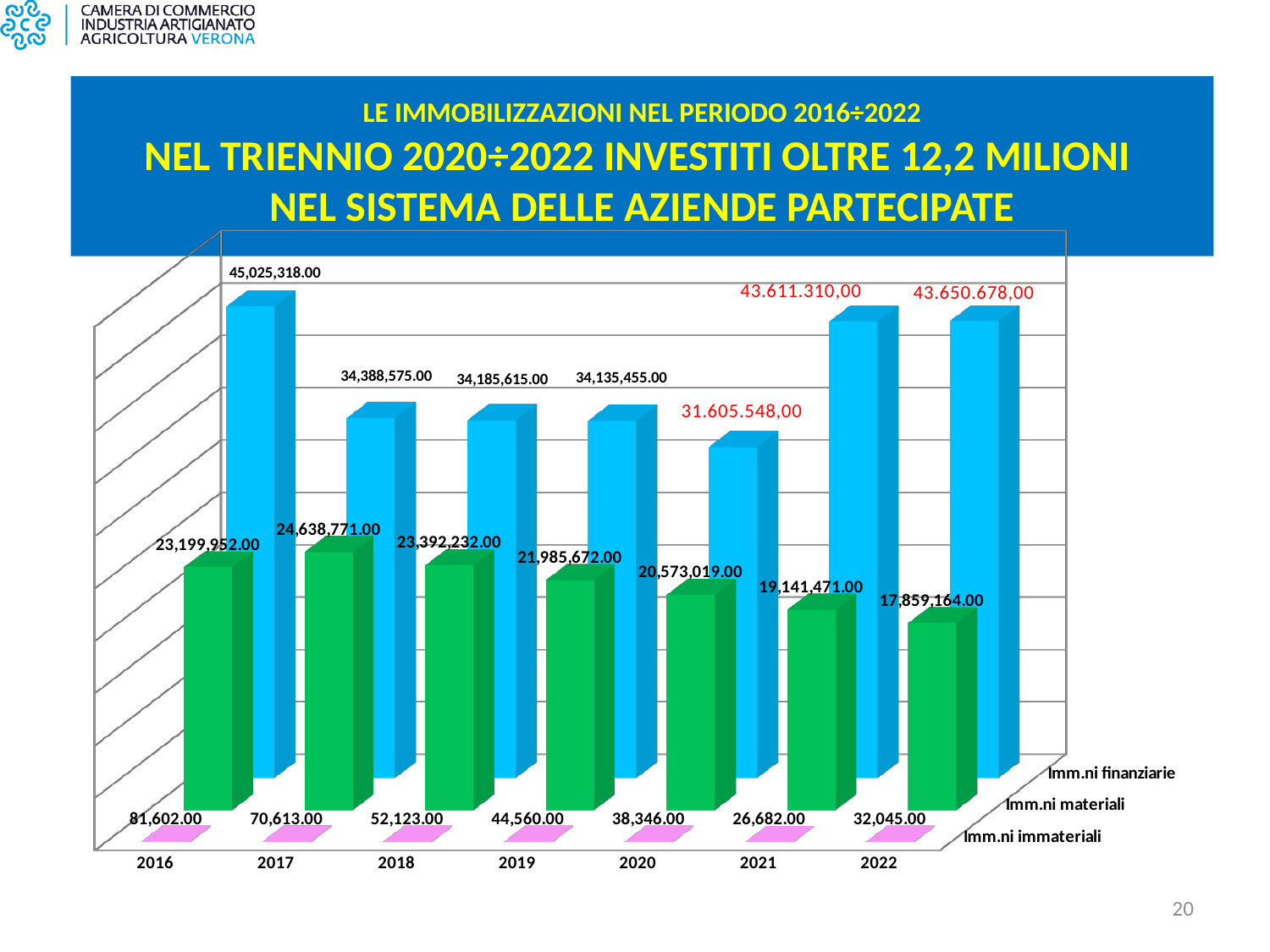
How many series does the chart show? 3 Which is larger, Imm.ni materiali in 2017 or in 2018? 2017 In which year is Imm.ni finanziarie highest? 2016 What is the value of Imm.ni immateriali for 2019? 44,560.00 What is the value of Imm.ni finanziarie for 2021? 43.611.310,00 What is the difference between Imm.ni immateriali in 2016 and in 2017? 10,989.00 In which year is Imm.ni immateriali highest? 2016 What type of chart is shown on the slide? Bar chart In which year is Imm.ni materiali lowest? 2022 How many years are shown on the x axis? 7 What is the value of Imm.ni materiali for 2022? 17,859,164.00 What is the value of Imm.ni finanziarie for 2016? 45,025,318.00